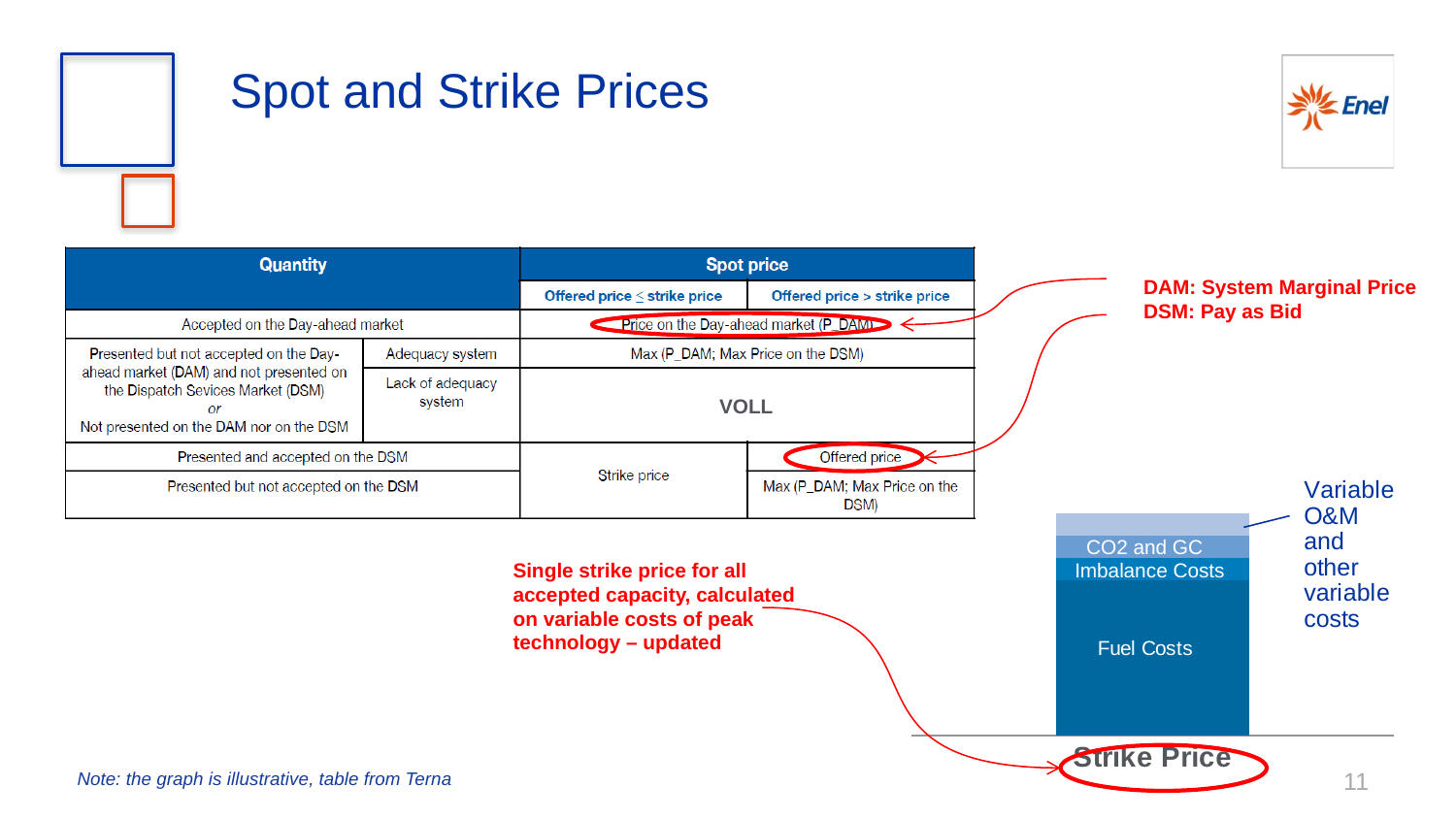
Which segment of the Strike Price bar is the largest? Fuel Costs What kind of chart is shown at the bottom right of the slide? bar chart Which segment sits at the bottom of the Strike Price bar? Fuel Costs In the Strike Price bar, which segment is larger: Fuel Costs or CO2 and GC Imbalance Costs? Fuel Costs How many segments make up the stacked bar labelled Strike Price? 4 What is the label under the stacked bar in the chart? Strike Price